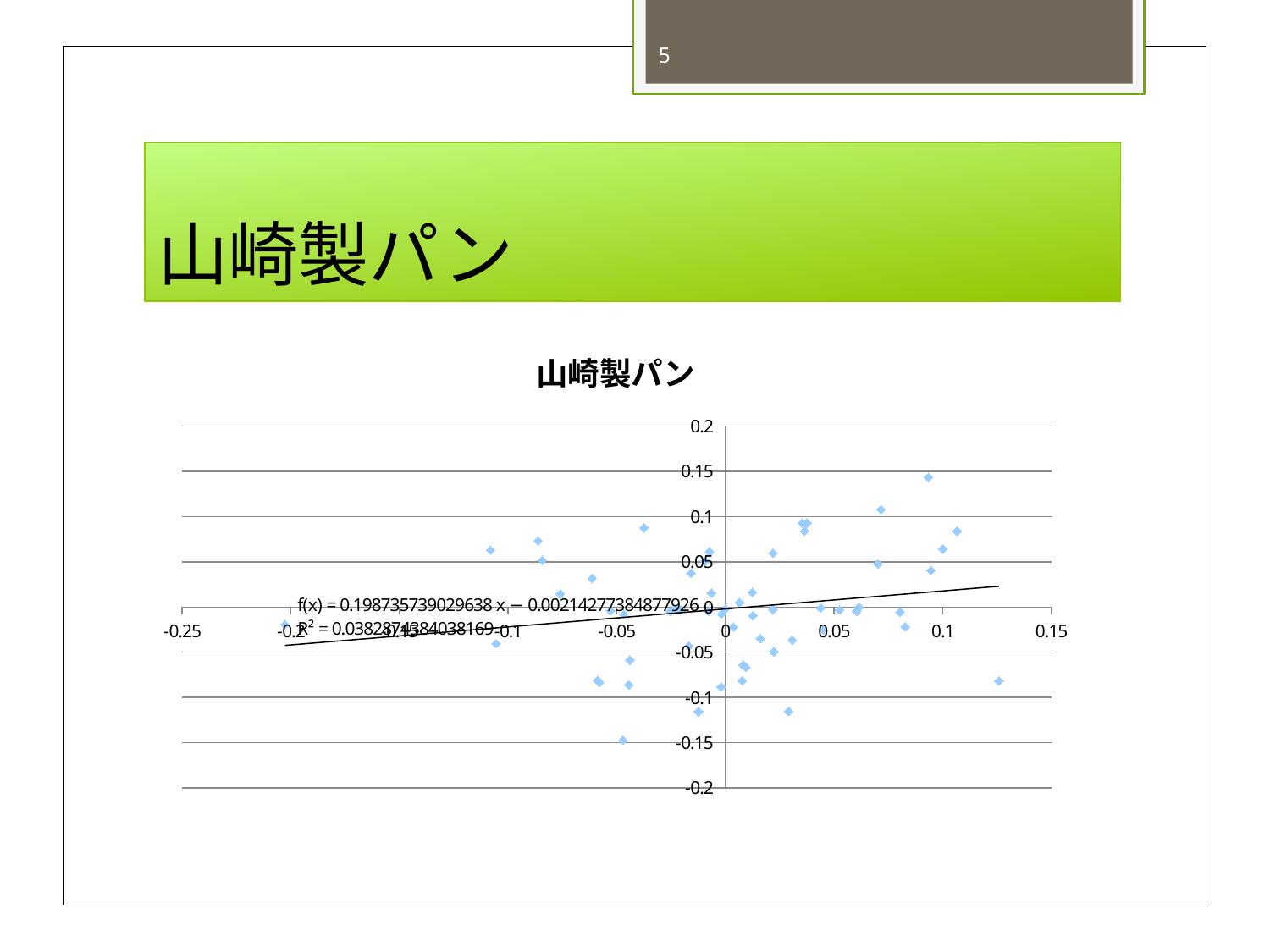
Is the y value of the highest plotted point greater or less than 0.1? greater What is the maximum value shown on the vertical axis? 0.2 What is the title of the chart? 山崎製パン What is the intercept shown in the trendline equation f(x)? −0.00214277384877926 Is the x value of the highest plotted point greater or less than 0.05? greater Is the x value of the lowest plotted point greater or less than 0? less Does the fitted trendline rise or fall as x increases? rise What kind of chart is shown on the slide? scatter chart What is the slope coefficient shown in the trendline equation f(x)? 0.198735739029638